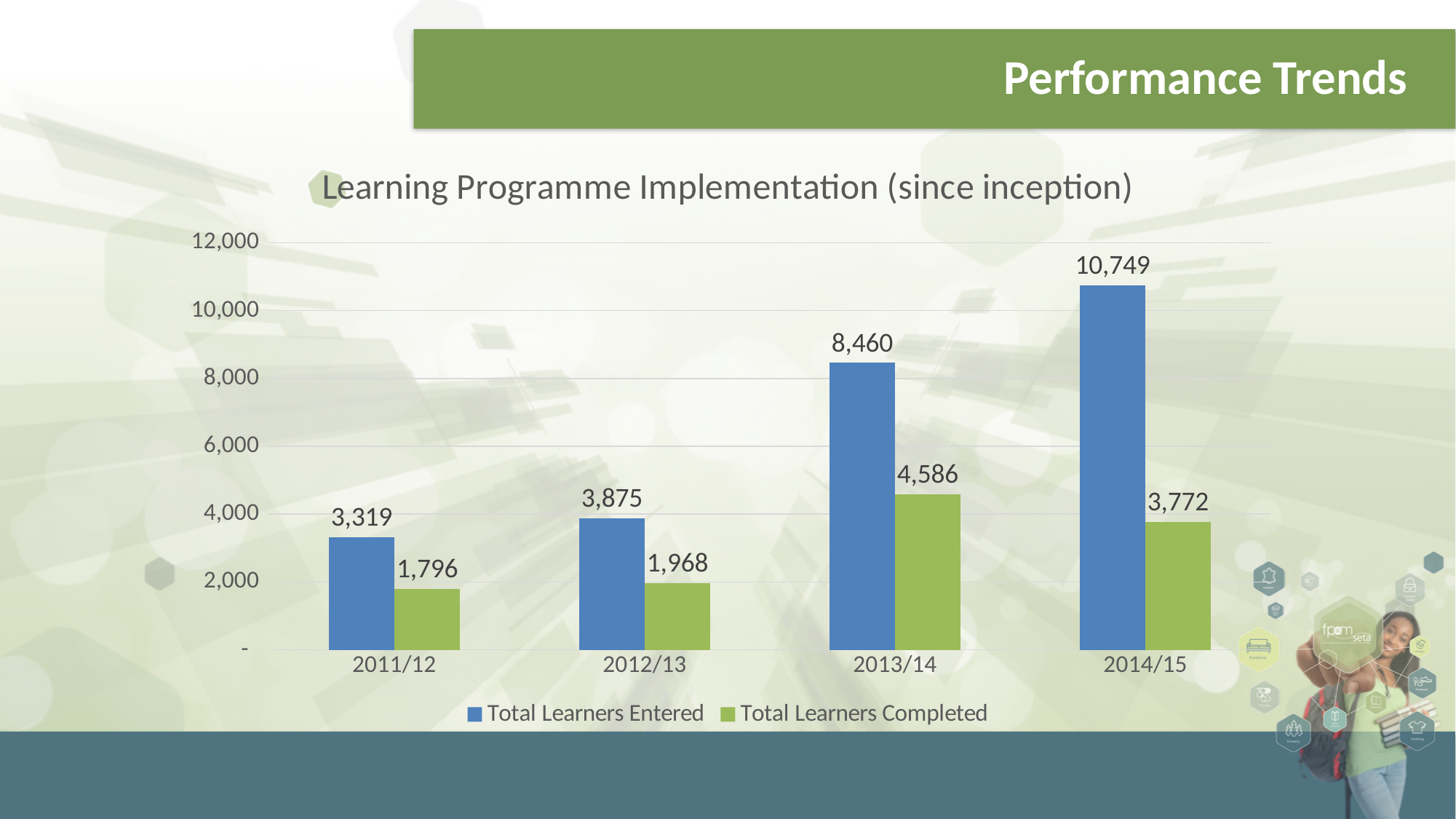
How many series does the legend list? 2 What is the value of Total Learners Entered for 2013/14? 8,460 How many years are shown on the x axis? 4 Which year has the highest value for Total Learners Entered? 2014/15 Which is larger: Total Learners Completed in 2013/14 or Total Learners Entered in 2012/13? Total Learners Completed in 2013/14 What is the difference between Total Learners Entered and Total Learners Completed in 2014/15? 6,977 What is the value of Total Learners Completed for 2014/15? 3,772 What is the title of the chart? Learning Programme Implementation (since inception) Which year has the lowest value for Total Learners Completed? 2011/12 What kind of chart is shown on the slide? bar chart Is the value for Total Learners Entered in 2012/13 greater or less than 4,000? less What is the value of Total Learners Completed for 2011/12? 1,796